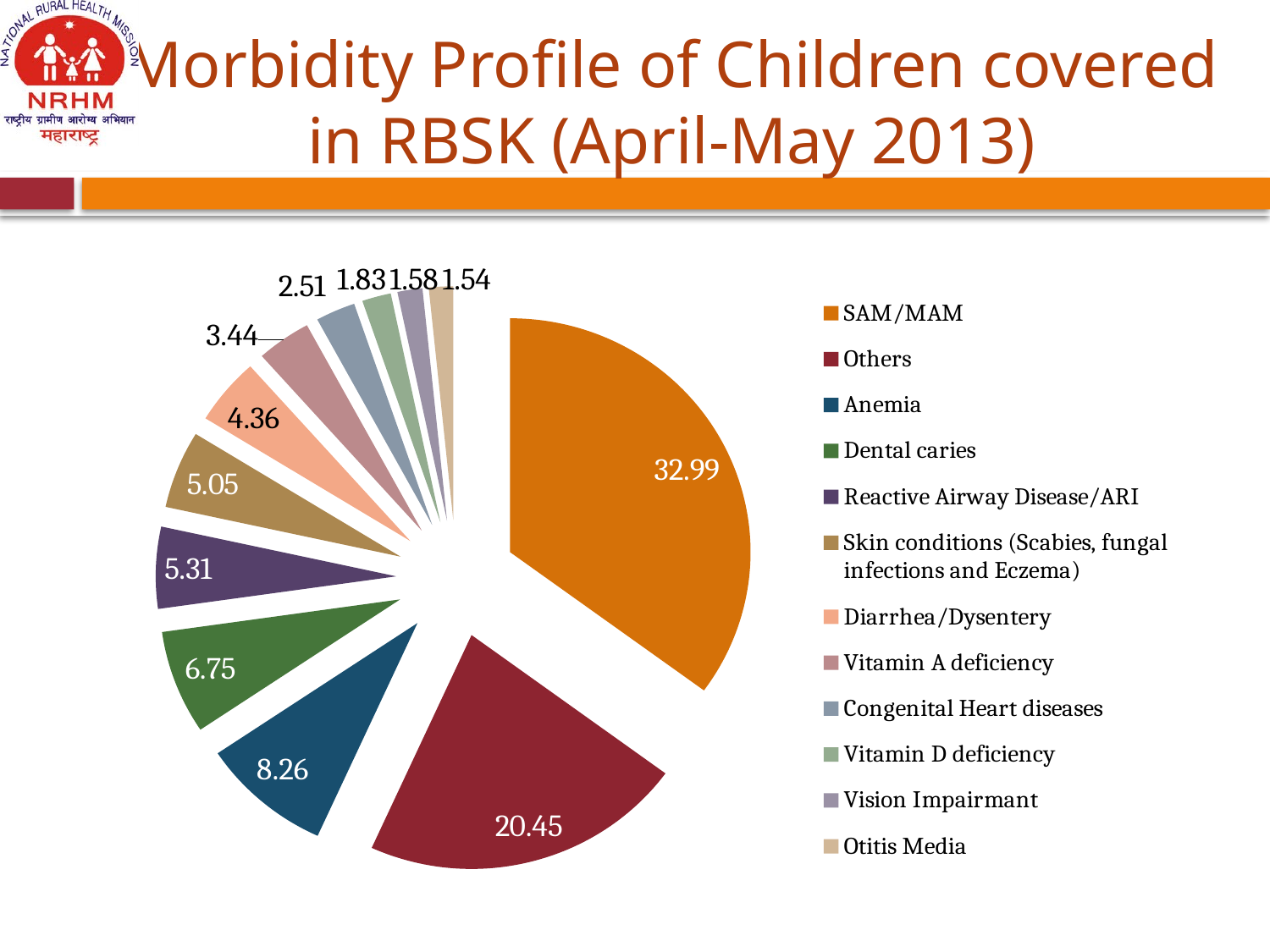
What is the value shown for SAM/MAM? 32.99 What is the value shown for Otitis Media? 1.54 What colour is the slice for Others? Dark red What is the value shown for Anemia? 8.26 What is the difference between the values for SAM/MAM and Others? 12.54 What kind of chart is shown on the slide? Pie chart How many categories are shown in the pie chart? 12 Which category has the smallest slice of the pie? Otitis Media What is the value shown for Dental caries? 6.75 What is the value shown for Diarrhea/Dysentery? 4.36 Which category has the largest slice of the pie? SAM/MAM Which is larger, the value for Reactive Airway Disease/ARI or the value for Skin conditions (Scabies, fungal infections and Eczema)? Reactive Airway Disease/ARI